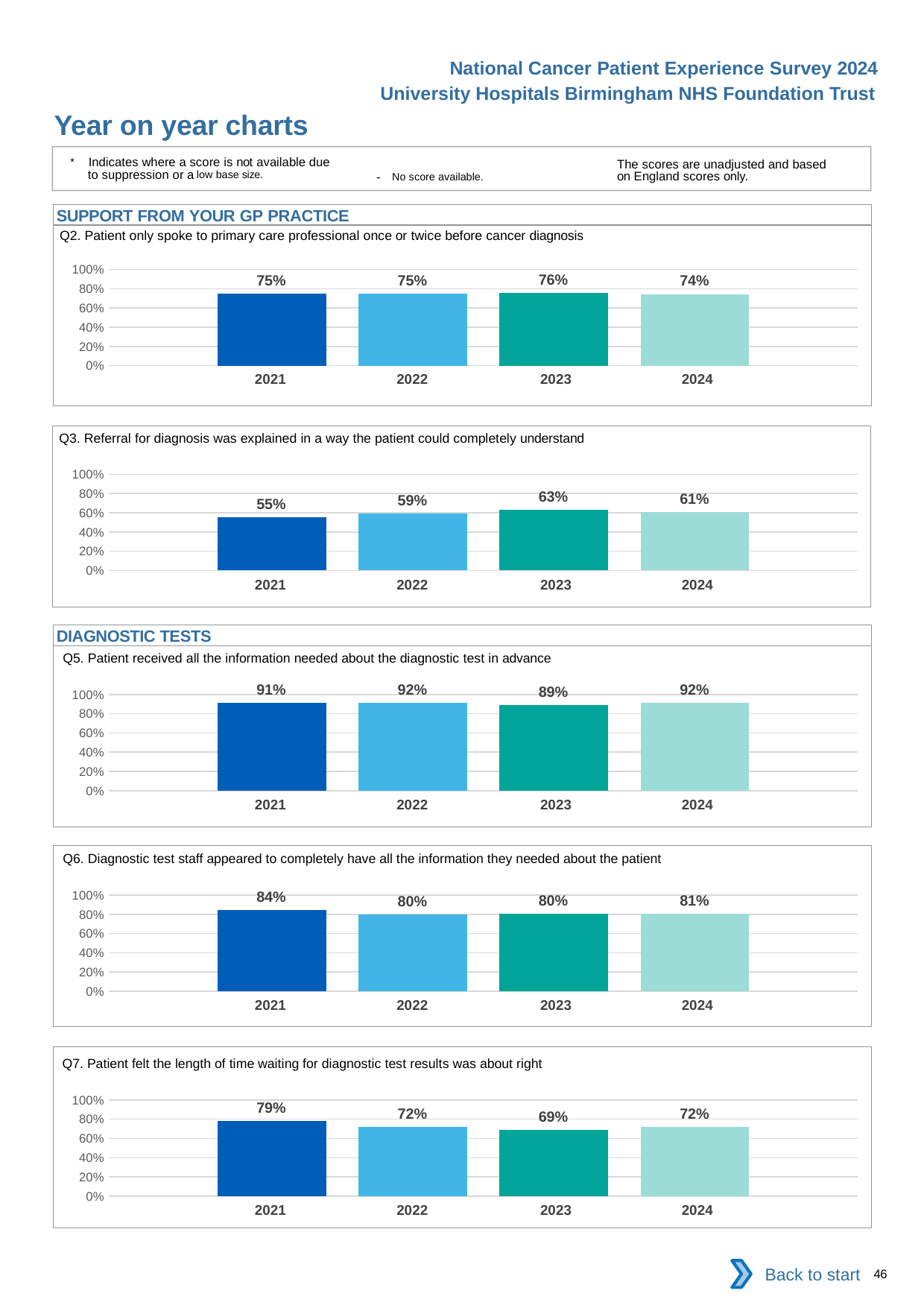
What type of chart is the Q3 chart (referral for diagnosis was explained in a way the patient could completely understand)? Bar chart In the Q5 chart (patient received all the information needed about the diagnostic test in advance), which year has the lowest value? 2023 In the Q7 chart (patient felt the length of time waiting for diagnostic test results was about right), what is the difference between the 2021 and 2024 values? 7 percentage points In the Q3 chart (referral for diagnosis was explained in a way the patient could completely understand), what is the difference between the 2023 and 2021 values? 8 percentage points In the Q7 chart (patient felt the length of time waiting for diagnostic test results was about right), which is larger, the value for 2021 or the value for 2023? 2021 In the Q5 chart (patient received all the information needed about the diagnostic test in advance), what is the value for 2023? 89% In the Q6 chart (diagnostic test staff appeared to completely have all the information they needed about the patient), which year has the highest value? 2021 In the Q2 chart (patient only spoke to primary care professional once or twice before cancer diagnosis), is the value for 2024 greater or less than 60%? greater How many years are shown on the x axis of the Q2 chart (patient only spoke to primary care professional once or twice before cancer diagnosis)? 4 In the Q6 chart (diagnostic test staff appeared to completely have all the information they needed about the patient), what is the value for 2024? 81% In the Q3 chart (referral for diagnosis was explained in a way the patient could completely understand), which year has the lowest value? 2021 In the Q2 chart (patient only spoke to primary care professional once or twice before cancer diagnosis), what is the value for 2023? 76%